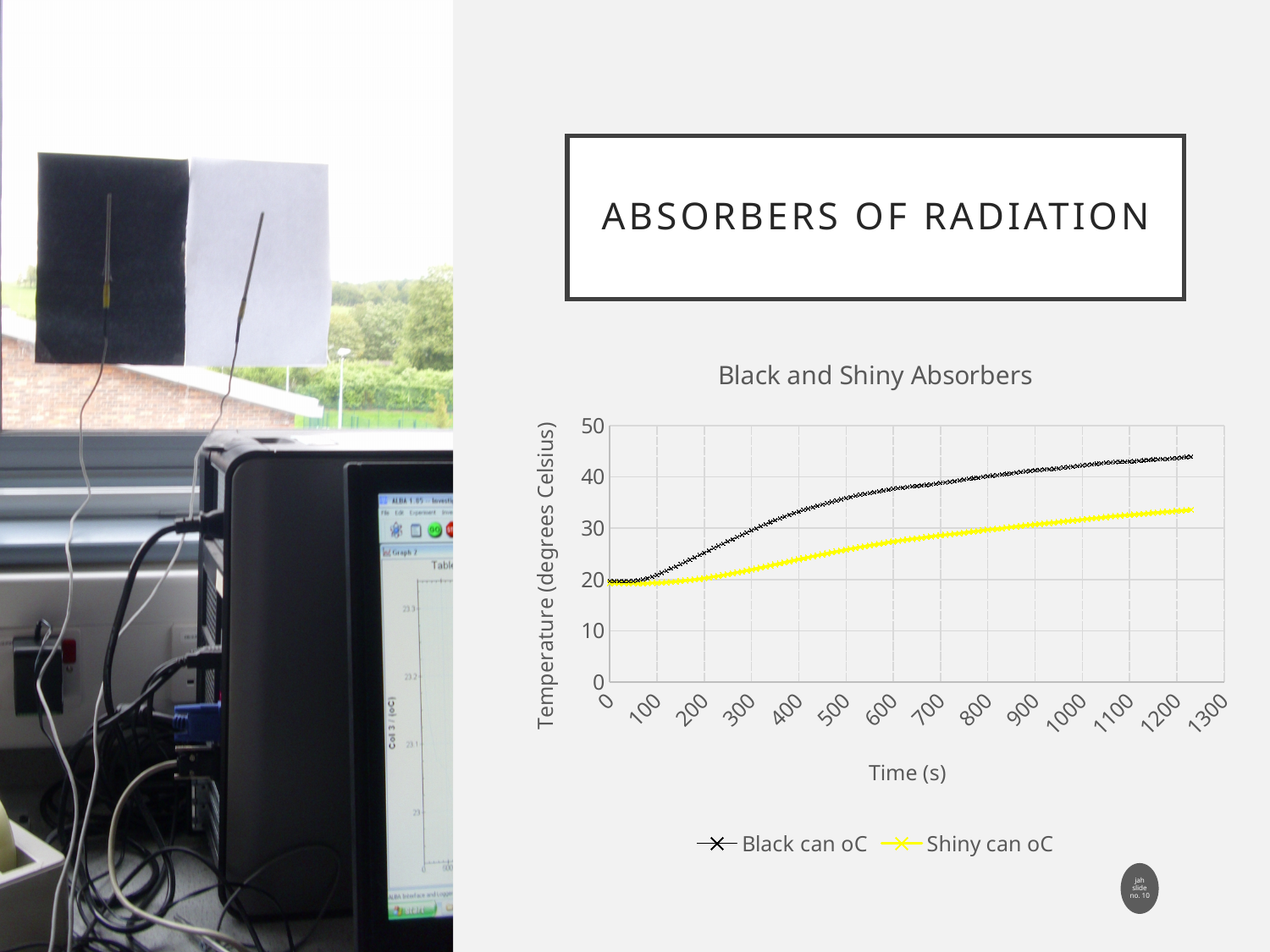
What is the title of the chart? Black and Shiny Absorbers Is the temperature of the Shiny can at 600 s greater or less than 30? less Is the temperature of the Black can at 1200 s greater or less than 40? greater Is the temperature of the Black can at 600 s greater or less than 30? greater Does the temperature of the Shiny can rise or fall as time increases? rise What is the label of the x axis of the chart? Time (s) Which series has the higher temperature at 600 s, Black can oC or Shiny can oC? Black can oC Does the temperature of the Black can rise or fall as time increases? rise Which series has the higher temperature at 1200 s, Black can oC or Shiny can oC? Black can oC How many series does the chart's legend list? 2 What kind of chart is shown on the slide? line chart